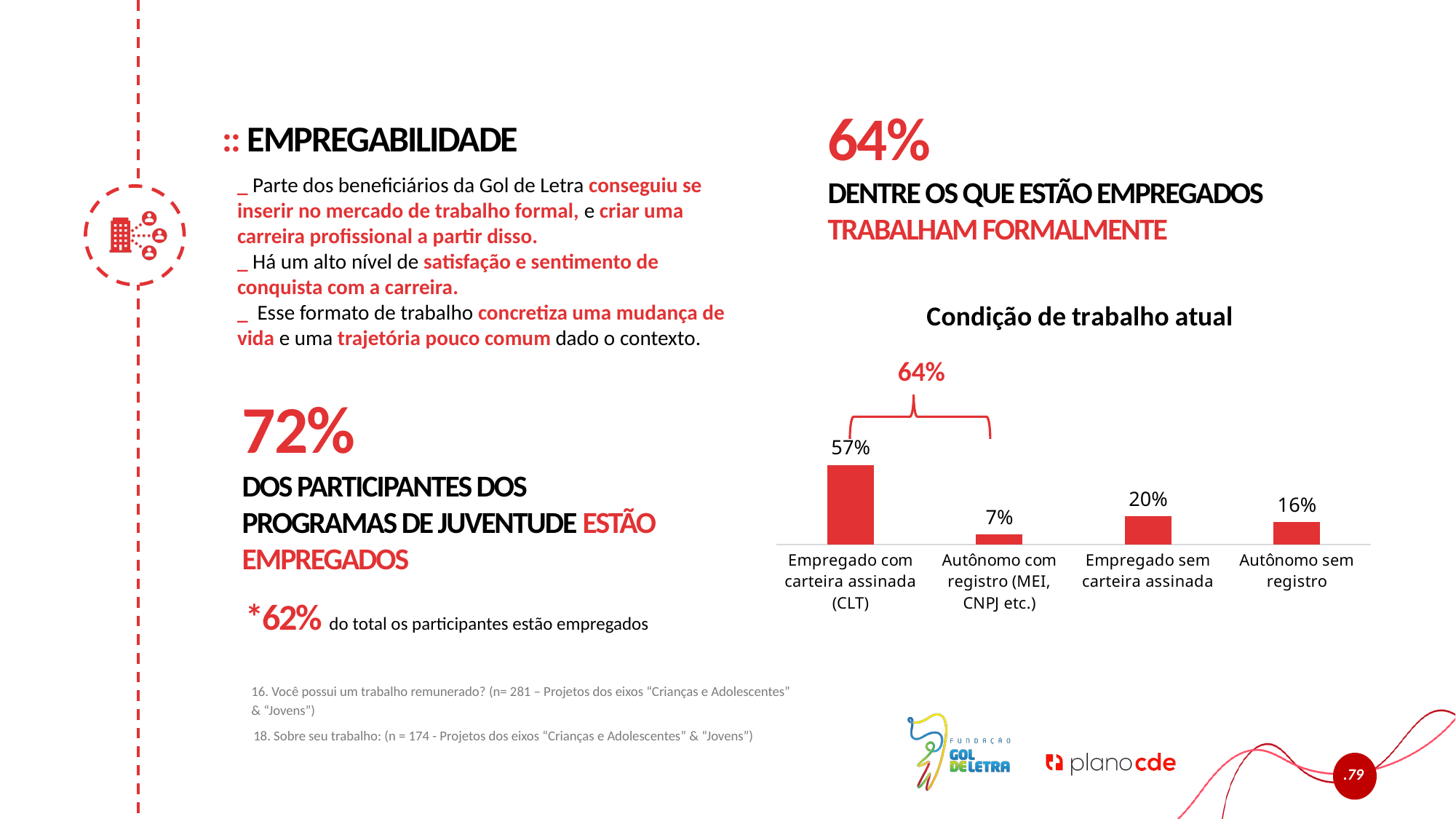
What is the value for "Empregado com carteira assinada (CLT)" in the "Condição de trabalho atual" chart? 57% What combined percentage does the bracket above the first two bars of the chart indicate? 64% What is the value for "Autônomo sem registro" in the chart? 16% What kind of chart is "Condição de trabalho atual"? Bar chart What is the value for "Autônomo com registro (MEI, CNPJ etc.)" in the chart? 7% What is the difference between the values for "Empregado com carteira assinada (CLT)" and "Empregado sem carteira assinada"? 37% How many categories are shown in the "Condição de trabalho atual" chart? 4 What is the title of the chart on the slide? Condição de trabalho atual Which category has the lowest value in the chart? Autônomo com registro (MEI, CNPJ etc.) Which is larger: the value for "Empregado sem carteira assinada" or "Autônomo sem registro"? Empregado sem carteira assinada Which category has the highest value in the "Condição de trabalho atual" chart? Empregado com carteira assinada (CLT) What is the value for "Empregado sem carteira assinada" in the chart? 20%